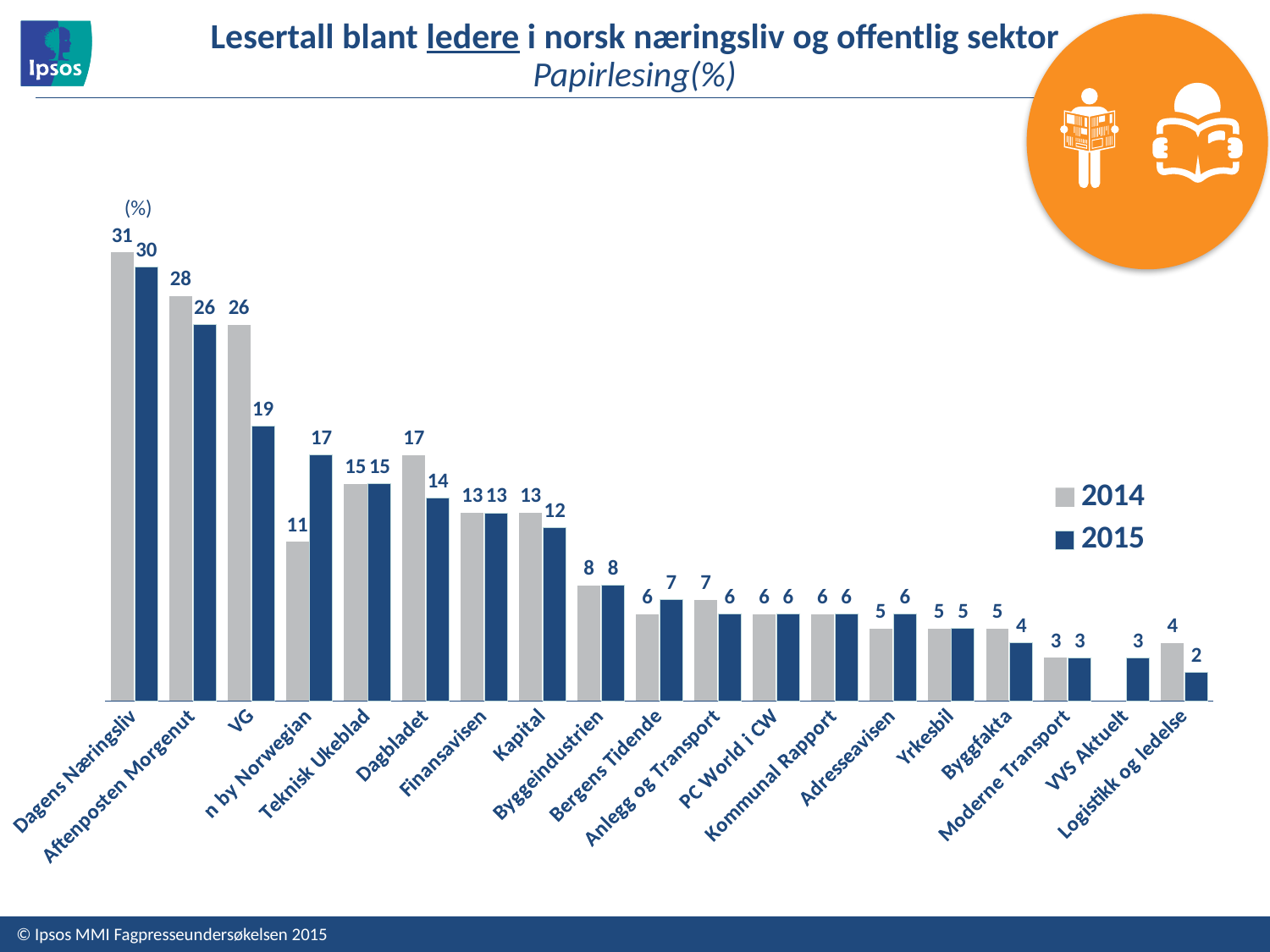
Which category has the lowest 2015 value? Logistikk og ledelse What kind of chart is shown on the slide? Bar chart Which category has the highest 2015 value? Dagens Næringsliv For n by Norwegian, which year has the larger value, 2014 or 2015? 2015 What is the 2015 value for VG? 19 What are the two entries in the legend? 2014 and 2015 How many series does the legend list? 2 What is the difference between the 2014 and 2015 values for VG? 7 How many categories are shown on the x axis? 19 What is the 2014 value for Dagbladet? 17 Do the 2014 values generally rise or fall from left to right along the x axis? Fall What is the 2015 value for Byggeindustrien? 8